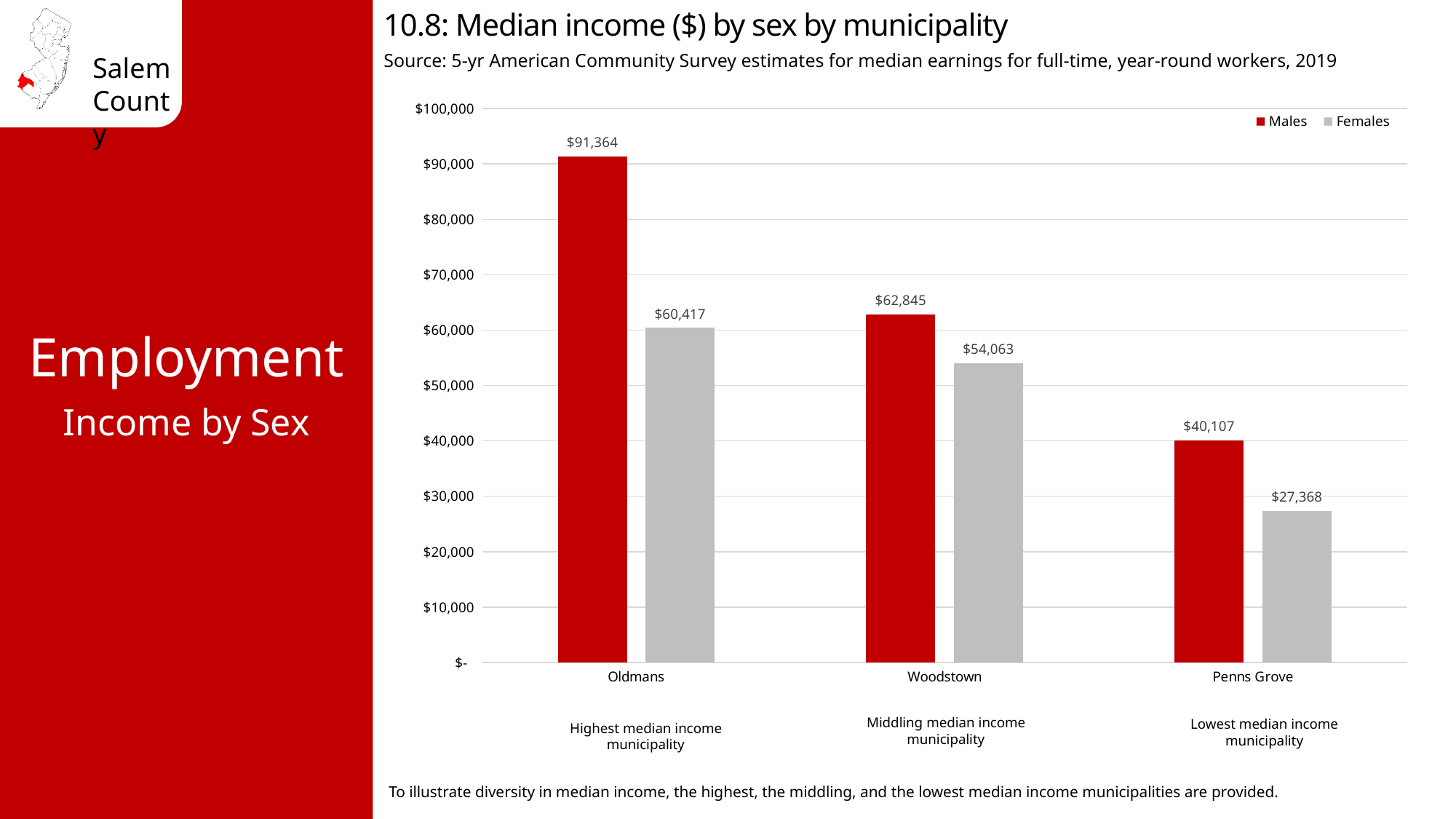
Which is larger: the female median income in Oldmans or the male median income in Woodstown? Male median income in Woodstown What is the median income for females in Woodstown? $54,063 What is the difference between male and female median income in Oldmans? $30,947 How many municipalities are shown on the chart? 3 What kind of chart is shown on the slide? Bar chart Which municipality has the highest median income for males? Oldmans Is the male median income in Penns Grove greater or less than $50,000? less Which municipality has the lowest median income for females? Penns Grove What is the median income for females in Penns Grove? $27,368 How many series does the legend list? 2 What is the median income for males in Oldmans? $91,364 What is the difference between male and female median income in Penns Grove? $12,739